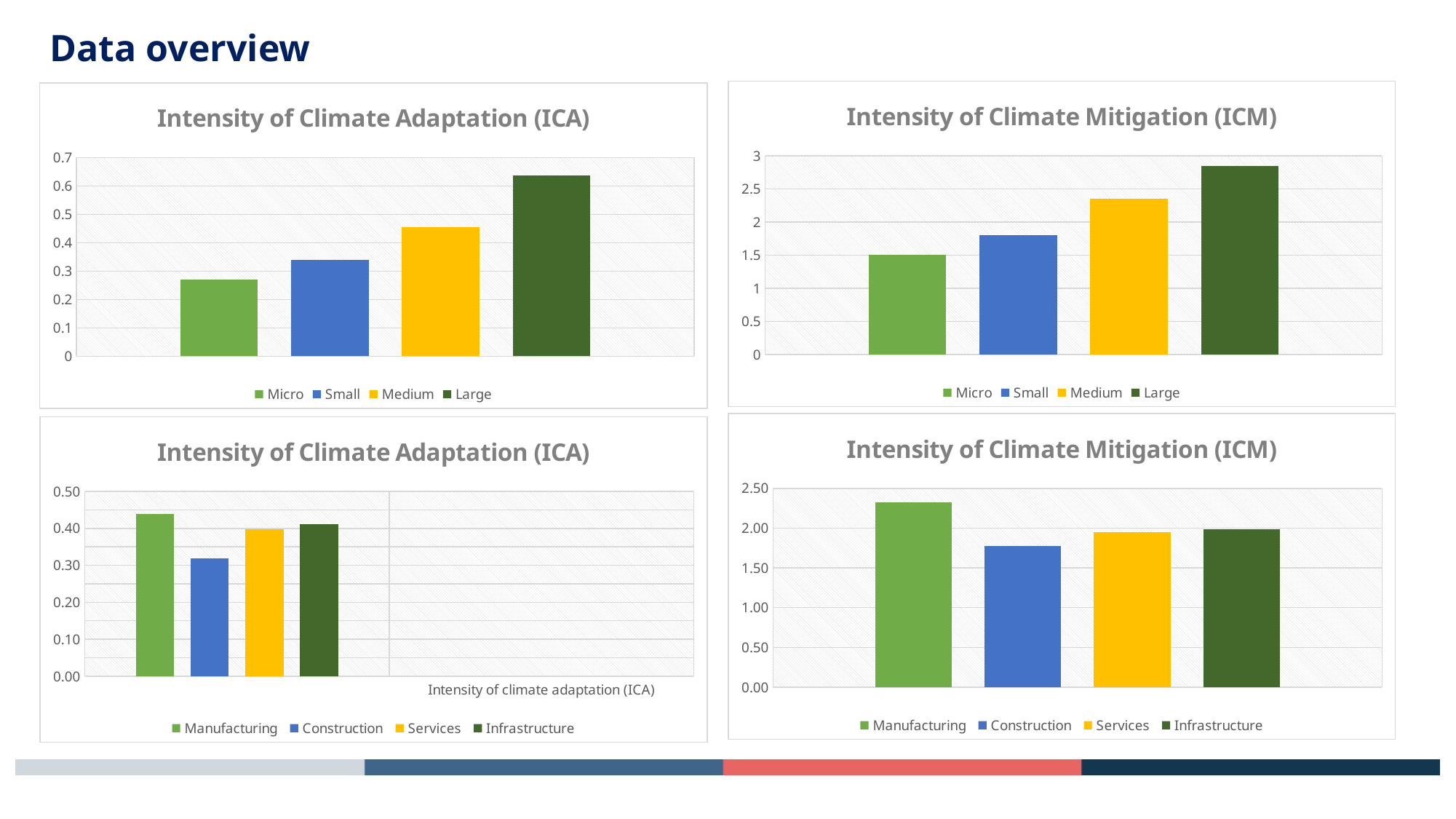
In the top-left chart (Intensity of Climate Adaptation by firm size), do the values rise or fall from Micro to Large? rise In the top-left chart (Intensity of Climate Adaptation by firm size), is the value for Large greater or less than 0.6? greater In the bottom-left chart (Intensity of Climate Adaptation by sector), which sector has the lowest value? Construction In the top-right chart (Intensity of Climate Mitigation by firm size), which category has the highest value? Large In the top-left chart (Intensity of Climate Adaptation by firm size), which category has the highest value? Large In the bottom-left chart (Intensity of Climate Adaptation by sector), which sector has the highest value? Manufacturing In the top-right chart (Intensity of Climate Mitigation by firm size), is the value for Large greater or less than 2.5? greater In the top-right chart (Intensity of Climate Mitigation by firm size), which is larger, Small or Medium? Medium In the bottom-right chart (Intensity of Climate Mitigation by sector), is the value for Manufacturing greater or less than 2.00? greater In the bottom-right chart (Intensity of Climate Mitigation by sector), which is larger, Construction or Services? Services In the top-left chart (Intensity of Climate Adaptation by firm size), which category has the lowest value? Micro How many entries does the legend of the bottom-right chart (Intensity of Climate Mitigation by sector) list? 4